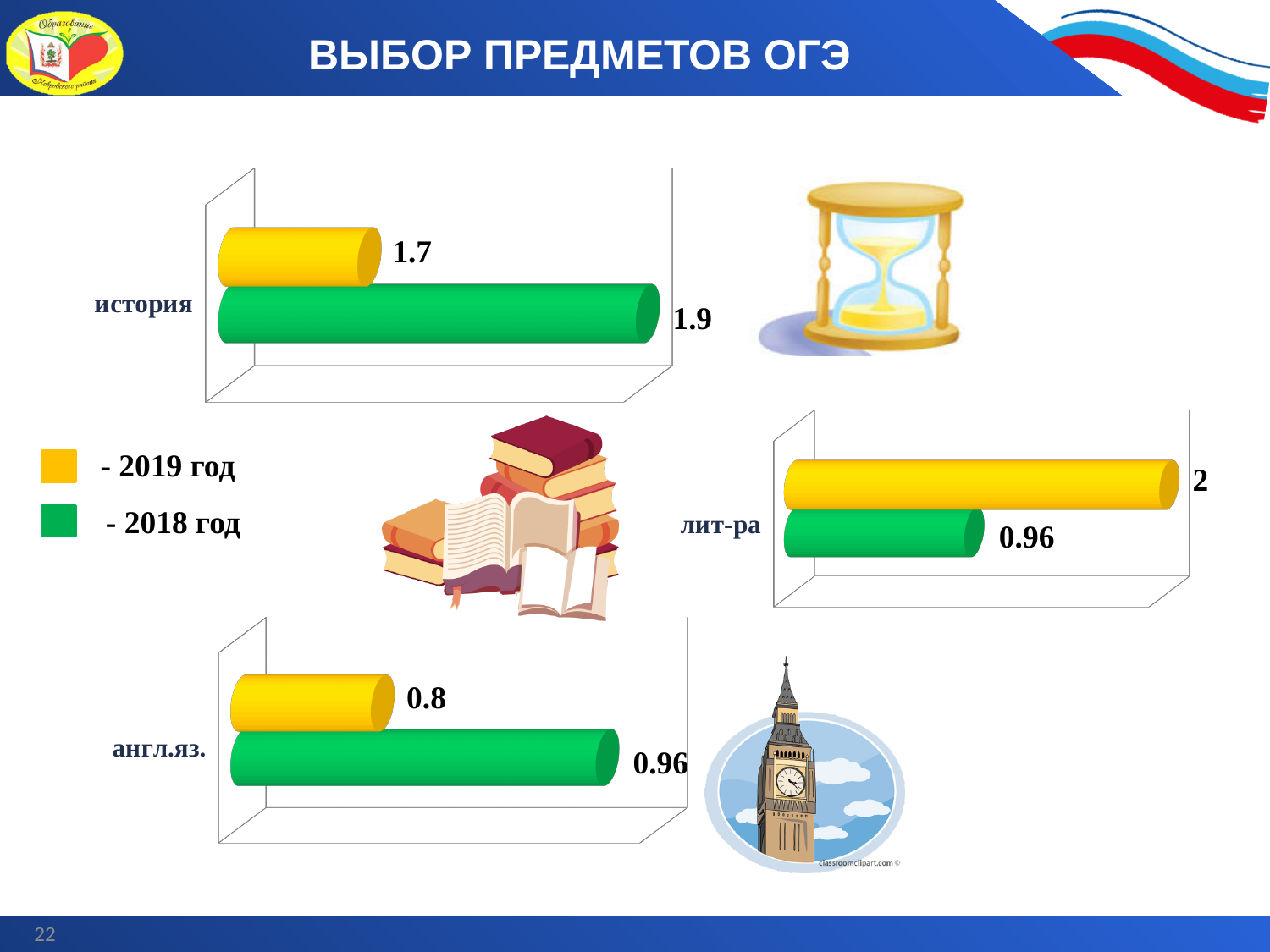
In the англ.яз. chart, what is the difference between the 2018 год and 2019 год values? 0.16 In the история chart, which year has the larger value, 2019 год or 2018 год? 2018 год In the история chart, what is the value for 2019 год? 1.7 What kind of chart is used for история, лит-ра and англ.яз. on this slide? Bar chart In the англ.яз. chart, what is the value for 2018 год? 0.96 In the лит-ра chart, which year has the larger value, 2019 год or 2018 год? 2019 год In the англ.яз. chart, what is the value for 2019 год? 0.8 In the лит-ра chart, what is the value for 2018 год? 0.96 Which year does the yellow colour represent in the legend? 2019 год In the лит-ра chart, what is the value for 2019 год? 2 In the история chart, what is the value for 2018 год? 1.9 In the лит-ра chart, what is the difference between the 2019 год and 2018 год values? 1.04